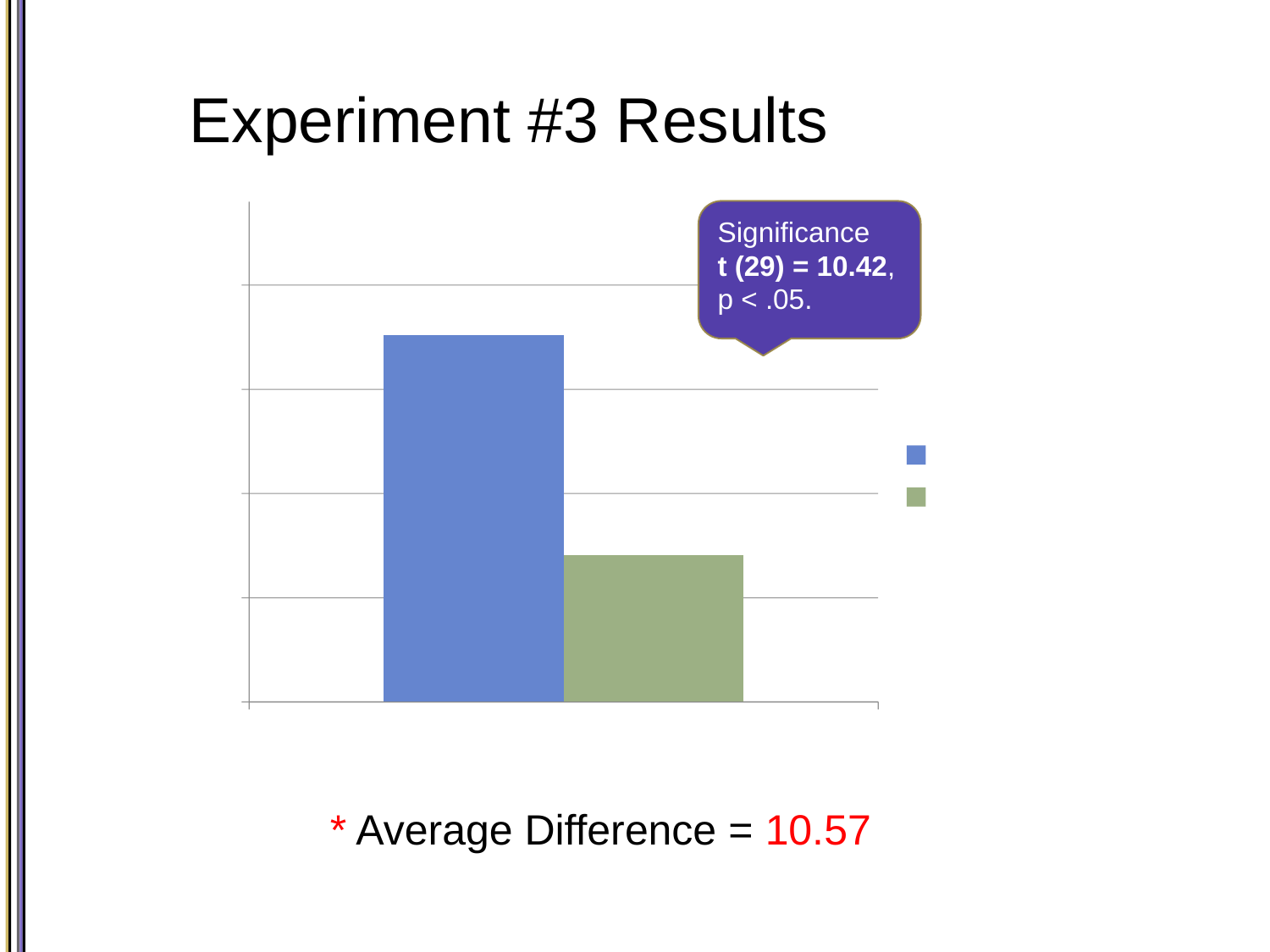
What colour is the first (left) bar in the chart? blue Which bar is taller, the blue bar or the green bar? the blue bar What kind of chart is shown on the slide? bar chart What colour is the second (right) bar in the chart? green How many entries does the chart's legend list? 2 Which colour bar has the lowest value in the chart? green Which colour bar has the highest value in the chart? blue How many bars are plotted in the chart? 2